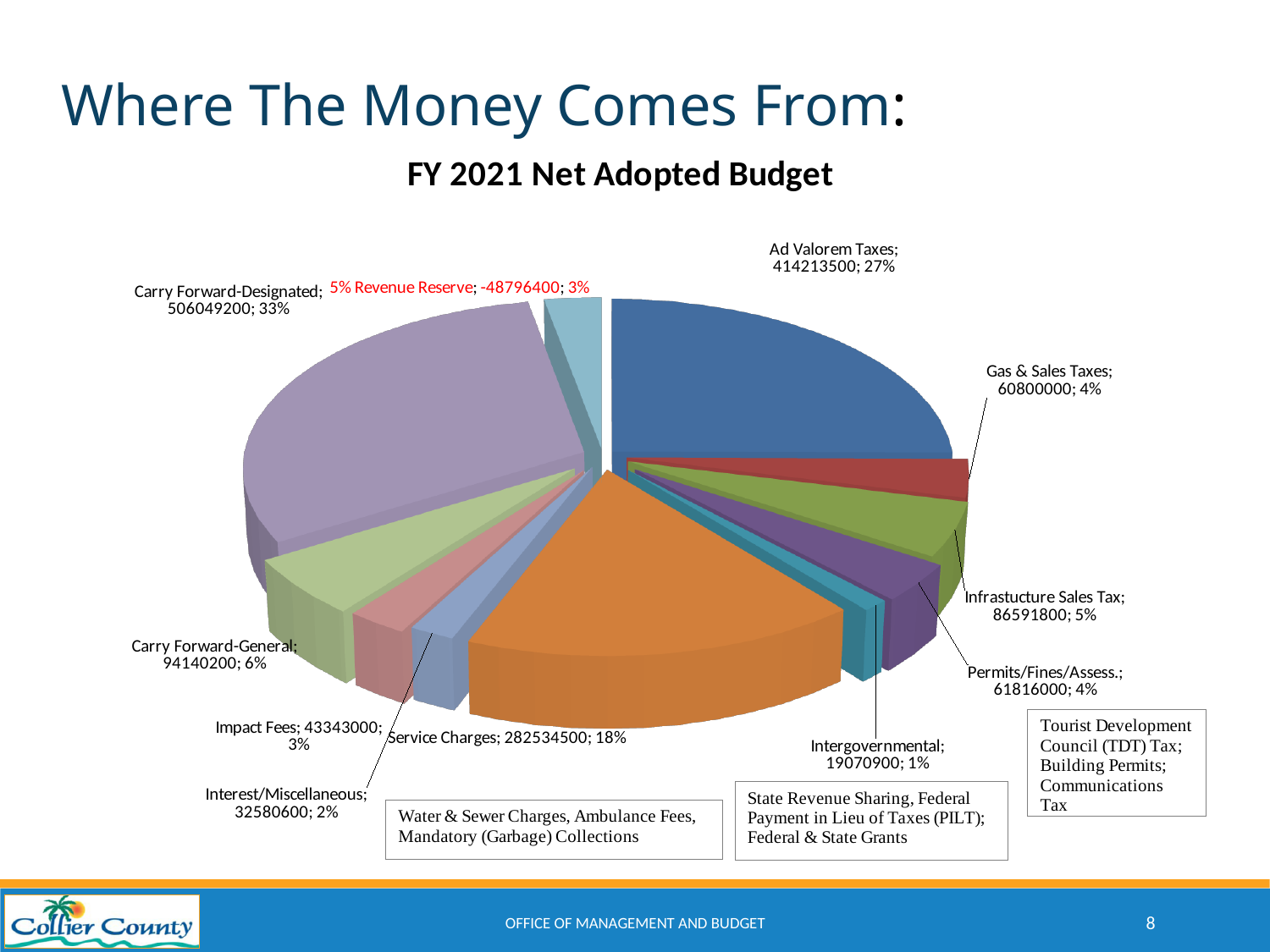
What is the title of the chart? FY 2021 Net Adopted Budget What is the difference between the values for Ad Valorem Taxes and Service Charges? 131679000 How many categories are shown in the pie chart? 11 What is the value for Service Charges? 282534500 What is the value for Ad Valorem Taxes? 414213500 Which category has the largest share of the pie? Carry Forward-Designated Which is larger, Infrastructure Sales Tax or Gas & Sales Taxes? Infrastructure Sales Tax Which category has the smallest share of the pie? Intergovernmental What is the value for the 5% Revenue Reserve? -48796400 What type of chart is shown on the slide? Pie chart What percentage share does Carry Forward-Designated represent? 33% What percentage share does Carry Forward-General represent? 6%